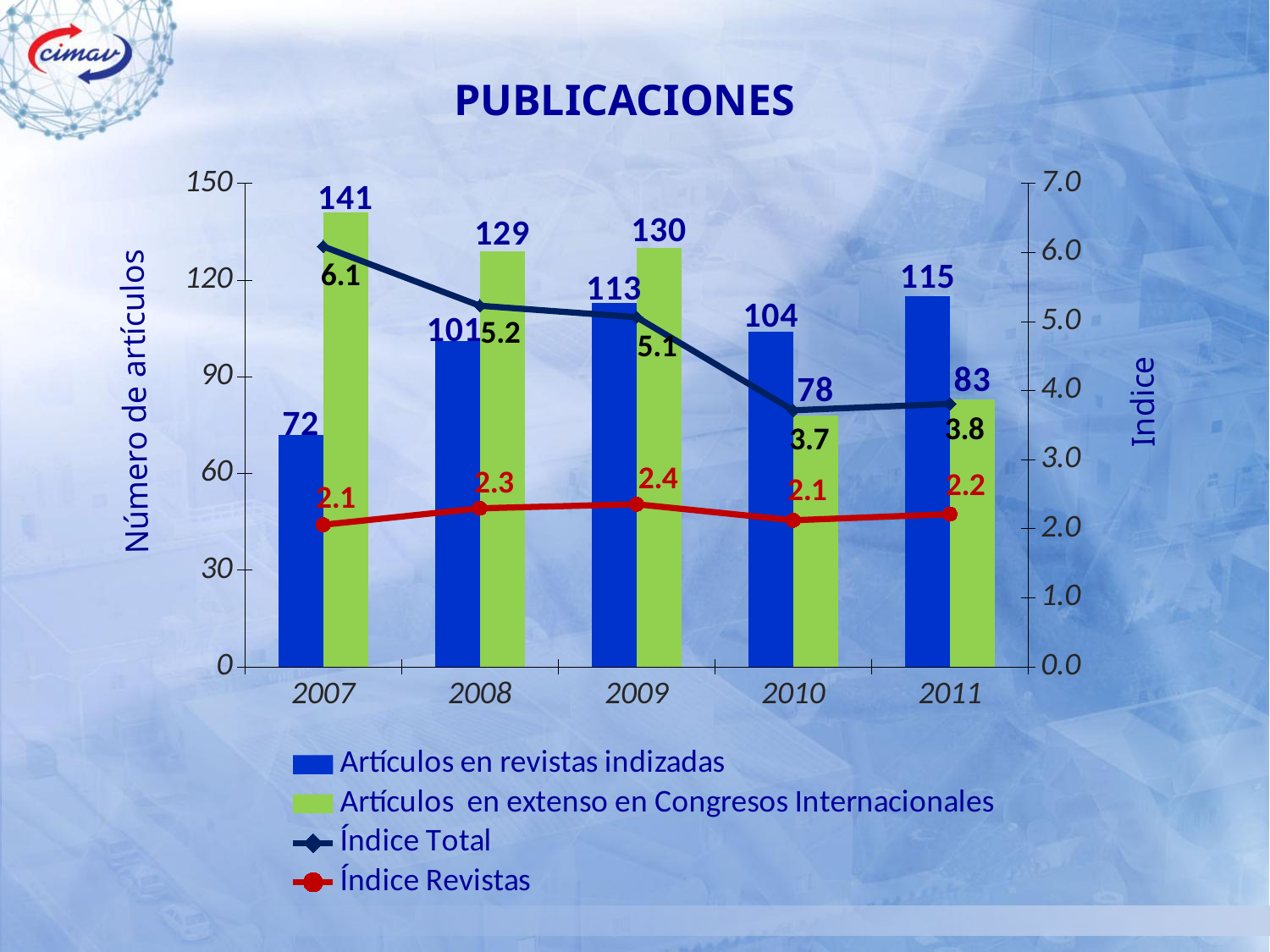
What is the title of the chart? PUBLICACIONES Does the Índice Total rise or fall from 2007 to 2010? fall What is the Índice Revistas value in 2009? 2.4 What is the value for Artículos en revistas indizadas in 2011? 115 How many series does the legend list? 4 What is the Índice Total value in 2010? 3.7 In which year is the value for Artículos en revistas indizadas highest? 2011 In which year is the value for Artículos en extenso en Congresos Internacionales lowest? 2010 How many years are shown on the x axis? 5 What is the value for Artículos en extenso en Congresos Internacionales in 2007? 141 Which is larger in 2010: Artículos en revistas indizadas or Artículos en extenso en Congresos Internacionales? Artículos en revistas indizadas What is the difference between Artículos en extenso en Congresos Internacionales and Artículos en revistas indizadas in 2007? 69